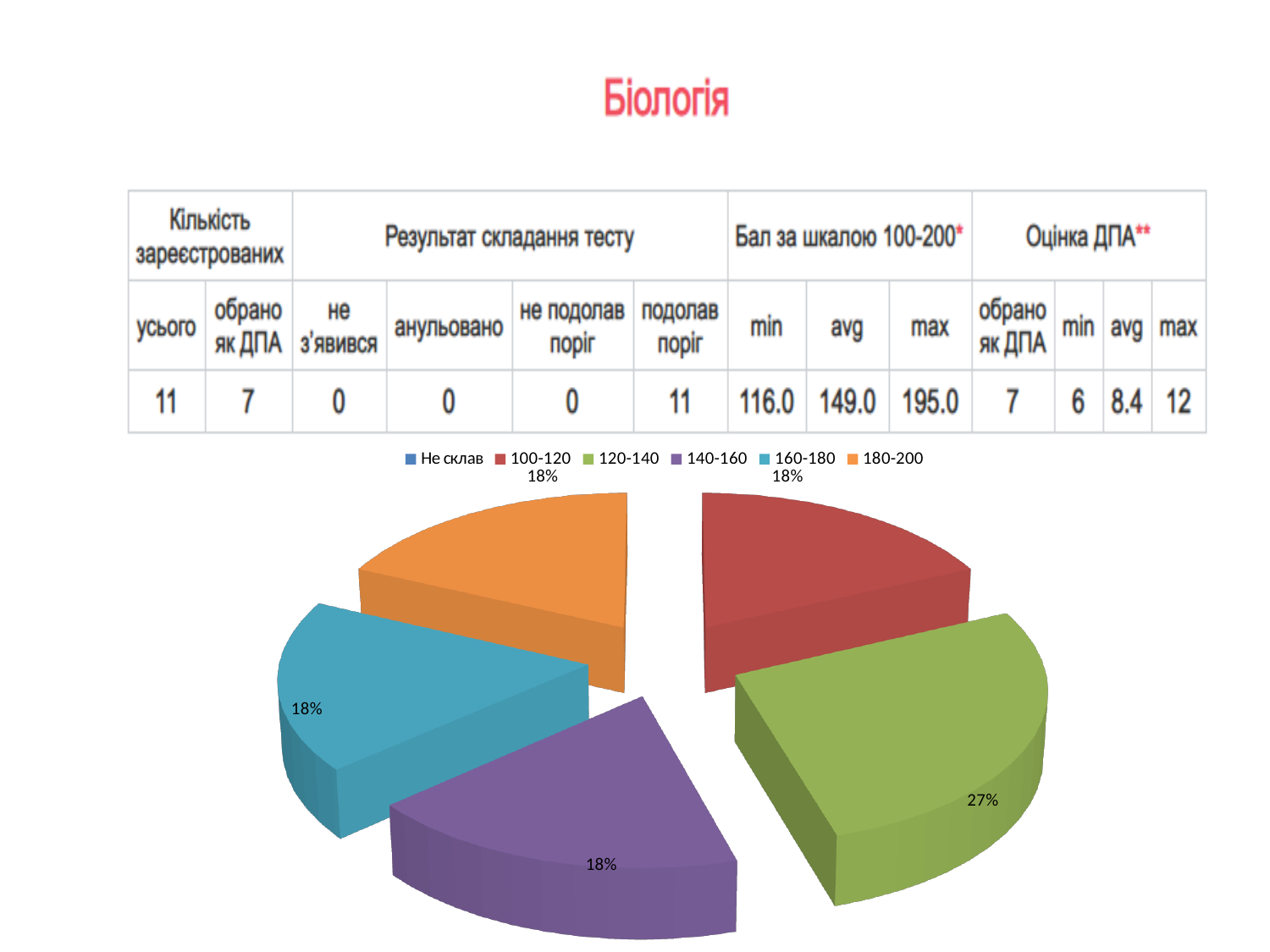
Which category has the largest slice of the pie? 120-140 What share of the pie does the 180-200 slice represent? 18% How many slices with data labels are visible in the pie chart? 5 Which slice is larger, 120-140 or 100-120? 120-140 What share of the pie does the 160-180 slice represent? 18% What share of the pie does the 100-120 slice represent? 18% What colour is the 120-140 slice in the pie chart? green What kind of chart is shown on the slide? pie chart By how many percentage points is the 120-140 slice larger than the 160-180 slice? 9% What share of the pie does the 140-160 slice represent? 18% What share of the pie does the 120-140 slice represent? 27% How many entries does the legend of the pie chart list? 6